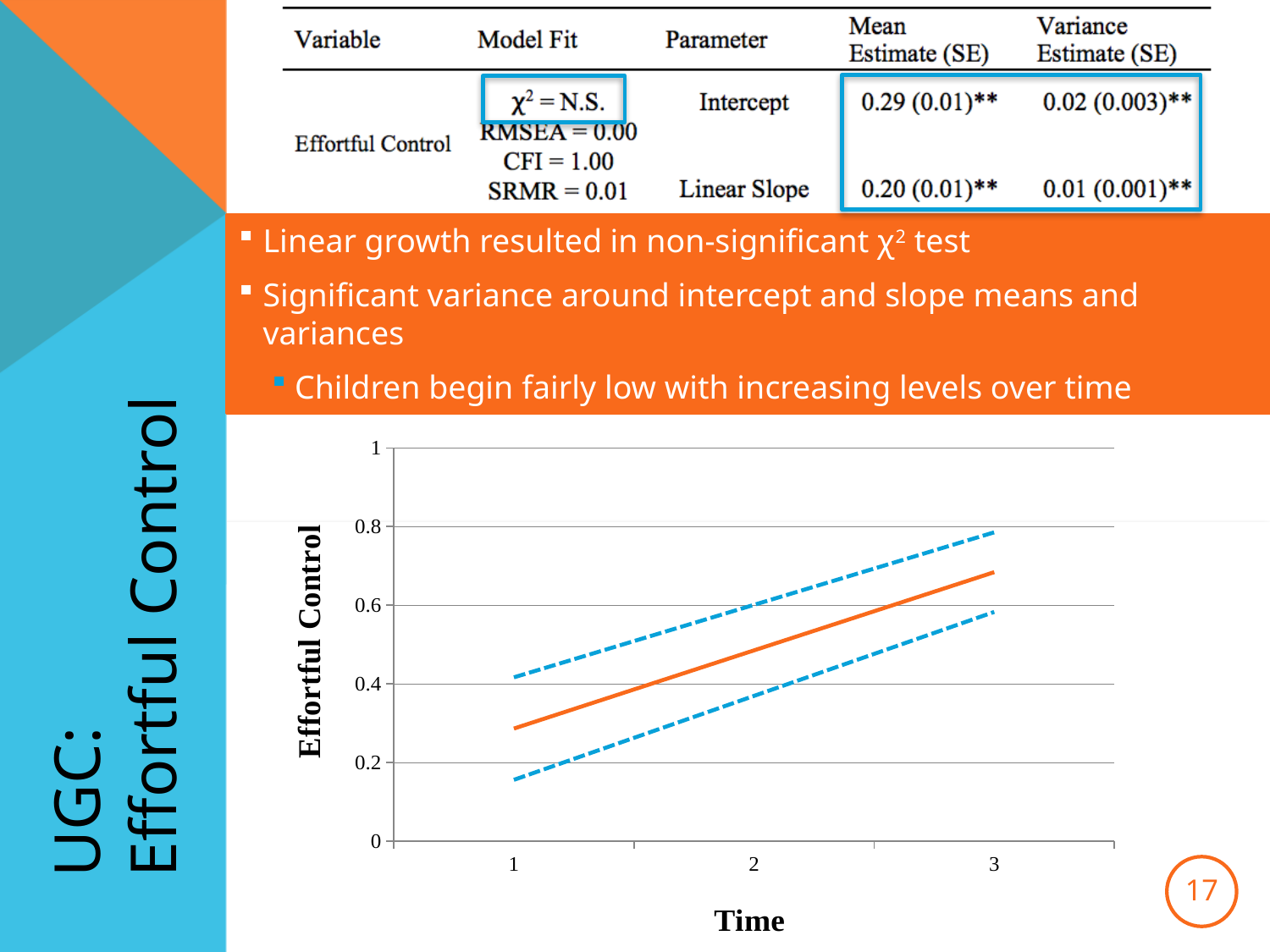
Do the lines in the chart rise or fall as Time increases from 1 to 3? rise Is the value of the lower dashed line at Time 1 greater or less than 0.2? less Is the value of the solid orange line at Time 3 greater or less than 0.6? greater Which is larger for the solid orange line: the value at Time 1 or the value at Time 3? Time 3 What is the title of the x axis of the chart? Time Is the value of the upper dashed line at Time 3 greater or less than 0.6? greater What is the title of the y axis of the chart? Effortful Control What kind of chart is shown on the slide? line chart How many lines are plotted in the chart? 3 How many time points are shown on the x axis of the chart? 3 What is the highest tick value shown on the y axis of the chart? 1